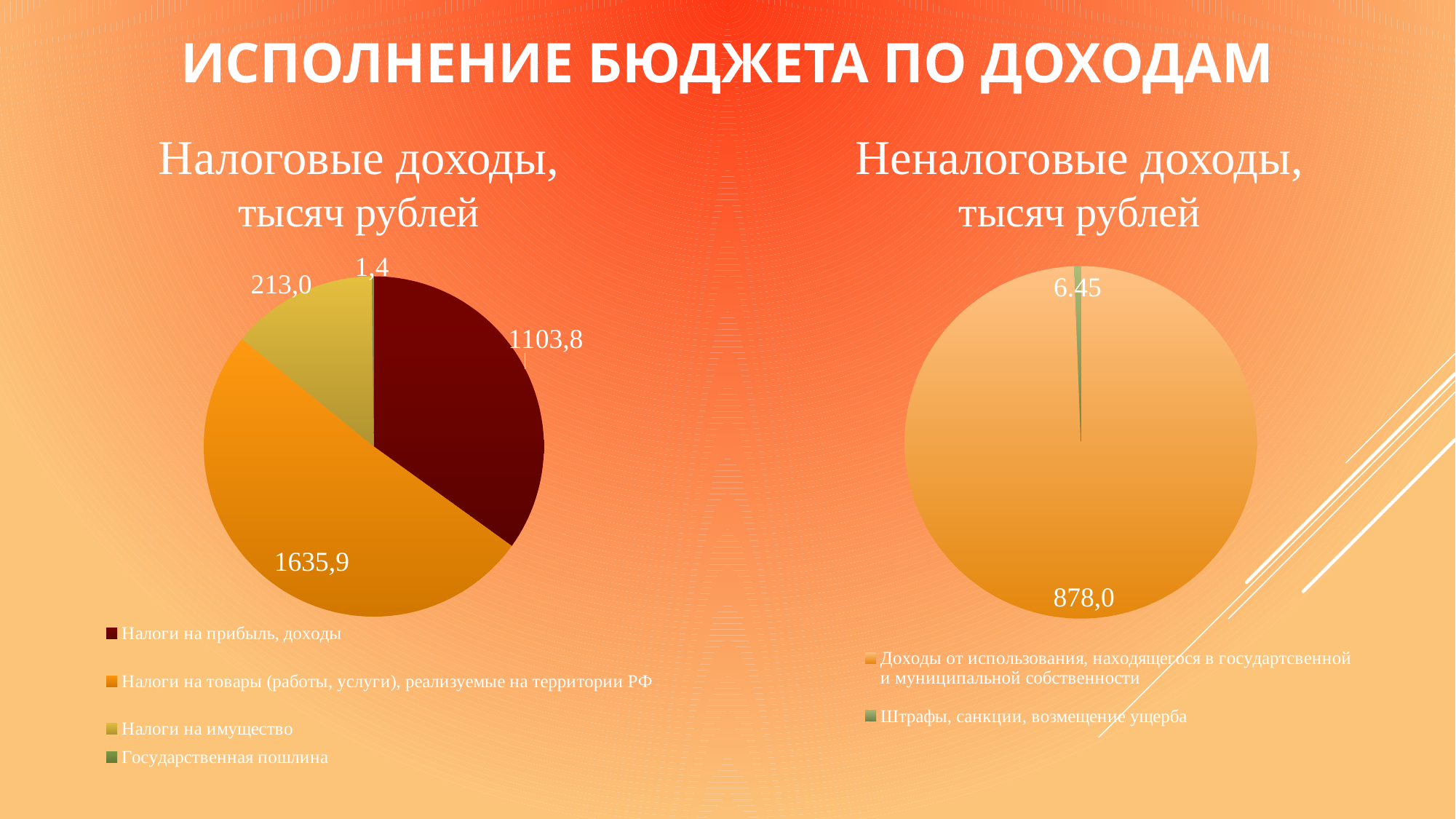
In the chart titled "Налоговые доходы, тысяч рублей", what is the difference between the values for "Налоги на товары (работы, услуги), реализуемые на территории РФ" and "Налоги на прибыль, доходы"? 532,1 How many categories does the chart titled "Неналоговые доходы, тысяч рублей" show? 2 In the chart titled "Налоговые доходы, тысяч рублей", what is the value for "Налоги на имущество"? 213,0 In the chart titled "Неналоговые доходы, тысяч рублей", what is the value for "Штрафы, санкции, возмещение ущерба"? 6.45 What is the title of the slide? ИСПОЛНЕНИЕ БЮДЖЕТА ПО ДОХОДАМ How many categories does the chart titled "Налоговые доходы, тысяч рублей" show? 4 In the chart titled "Неналоговые доходы, тысяч рублей", which category has the largest slice? Доходы от использования, находящегося в государственной и муниципальной собственности In the chart titled "Налоговые доходы, тысяч рублей", which is larger: "Налоги на прибыль, доходы" or "Налоги на имущество"? Налоги на прибыль, доходы In the chart titled "Налоговые доходы, тысяч рублей", which category has the largest slice? Налоги на товары (работы, услуги), реализуемые на территории РФ What kind of chart is the chart titled "Неналоговые доходы, тысяч рублей"? Pie chart In the chart titled "Налоговые доходы, тысяч рублей", which category has the smallest slice? Государственная пошлина In the chart titled "Налоговые доходы, тысяч рублей", what is the value for "Налоги на товары (работы, услуги), реализуемые на территории РФ"? 1635,9